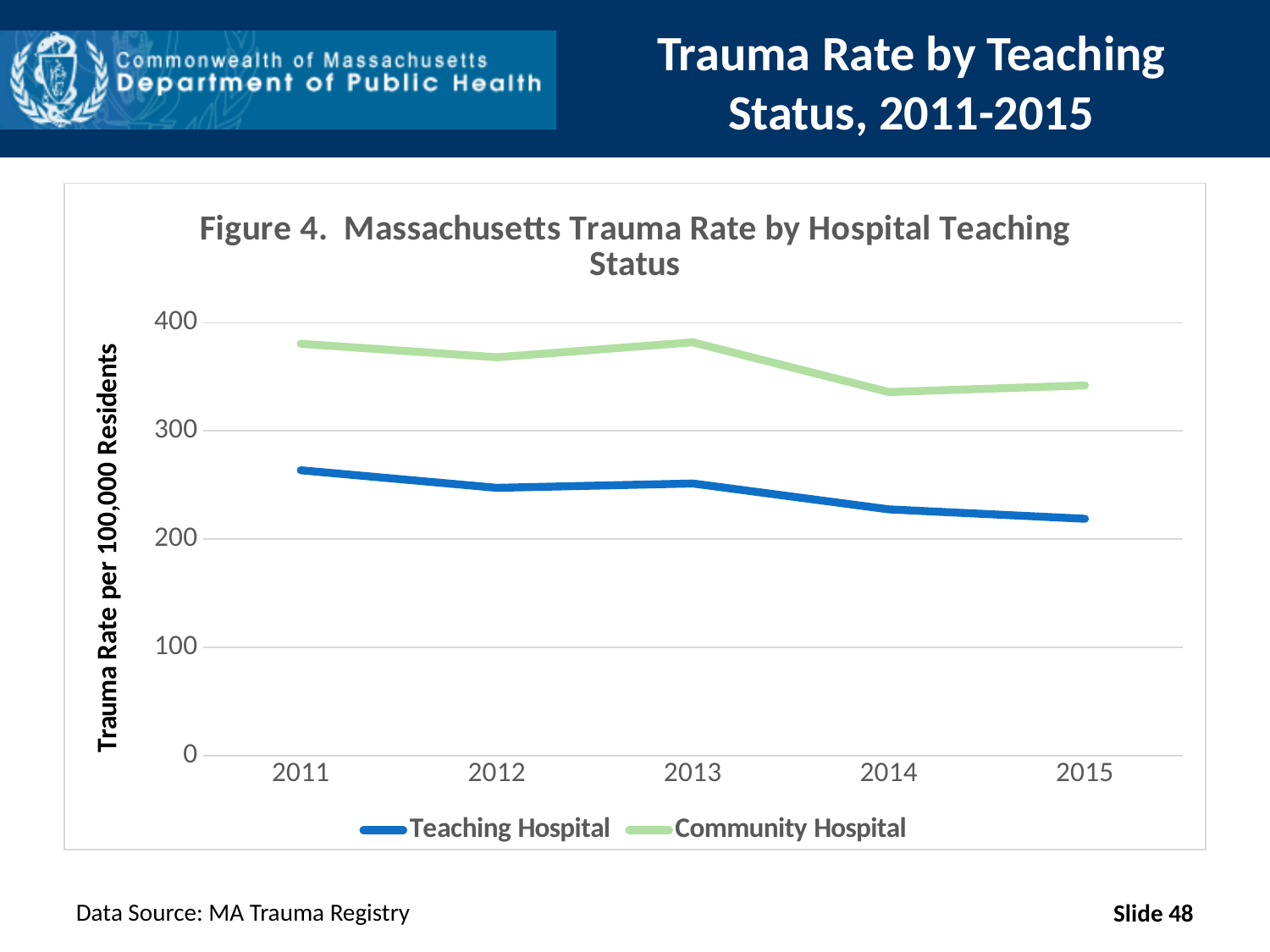
Which series is drawn in light green in Figure 4? Community Hospital How many series does the legend of Figure 4 list? 2 How many years are plotted along the x axis of Figure 4? 5 What kind of chart is shown in Figure 4? Line chart Is the Community Hospital trauma rate in 2014 greater or less than 300? greater Does the Teaching Hospital trauma rate generally rise or fall from 2011 to 2015? Fall Which series has the higher trauma rate in 2013, Teaching Hospital or Community Hospital? Community Hospital What is the label on the vertical axis of Figure 4? Trauma Rate per 100,000 Residents Is the Community Hospital trauma rate in 2011 greater or less than 400? less In which year is the Teaching Hospital trauma rate highest? 2011 Is the Teaching Hospital trauma rate in 2011 greater or less than 200? greater